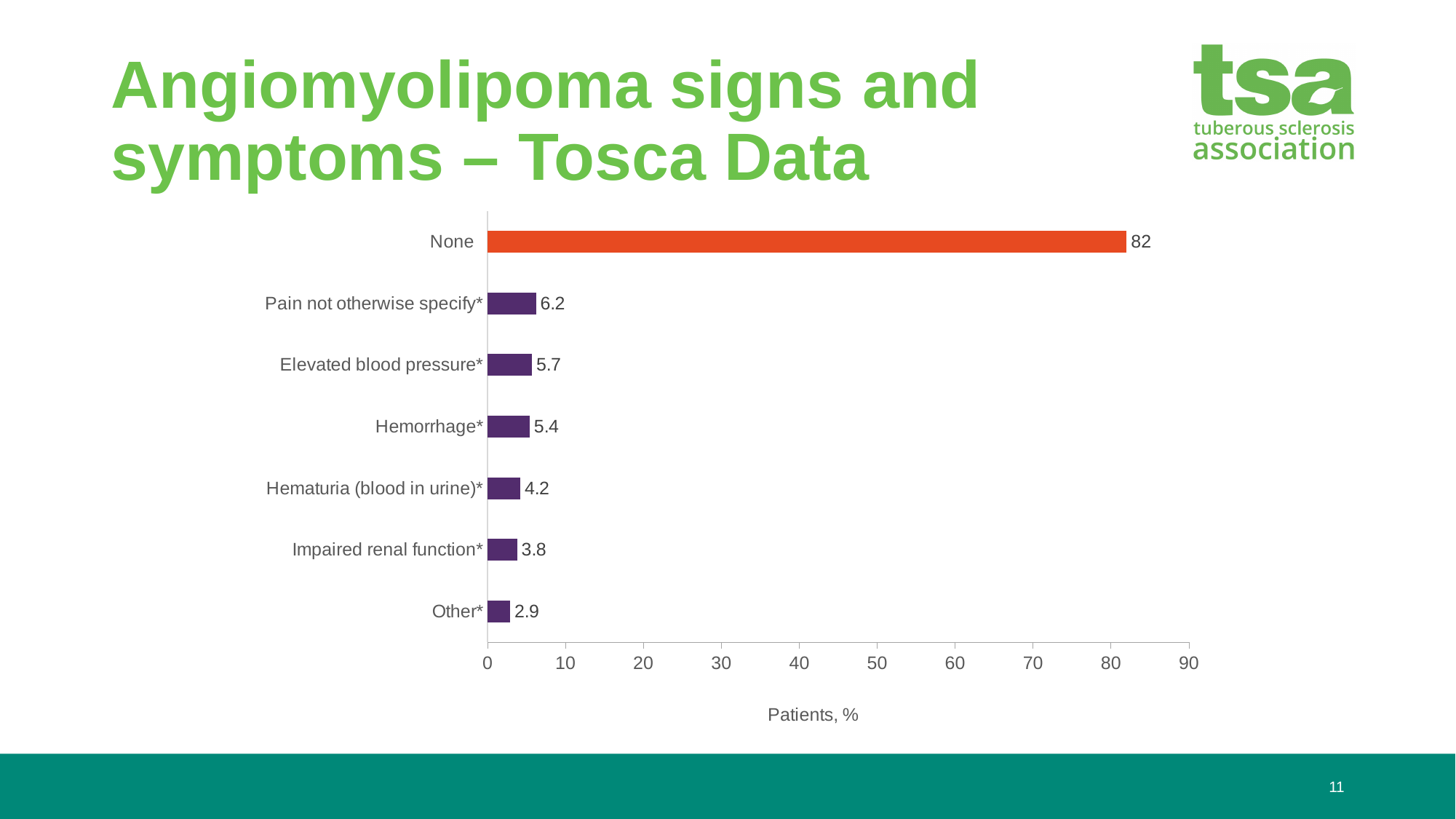
What is the label of the horizontal axis? Patients, % What is the difference between the values for Pain not otherwise specify* and Elevated blood pressure*? 0.5 Which is larger, the value for Hematuria (blood in urine)* or the value for Impaired renal function*? Hematuria (blood in urine)* How many categories are shown in the chart? 7 Which category has the lowest value? Other* What is the value for Impaired renal function*? 3.8 Which category has the highest value? None What percentage of patients had no angiomyolipoma signs or symptoms (None)? 82 What kind of chart is shown on the slide? Bar chart What is the difference between the values for None and Other*? 79.1 What is the value for Hemorrhage*? 5.4 Is the value for None greater or less than 80? greater